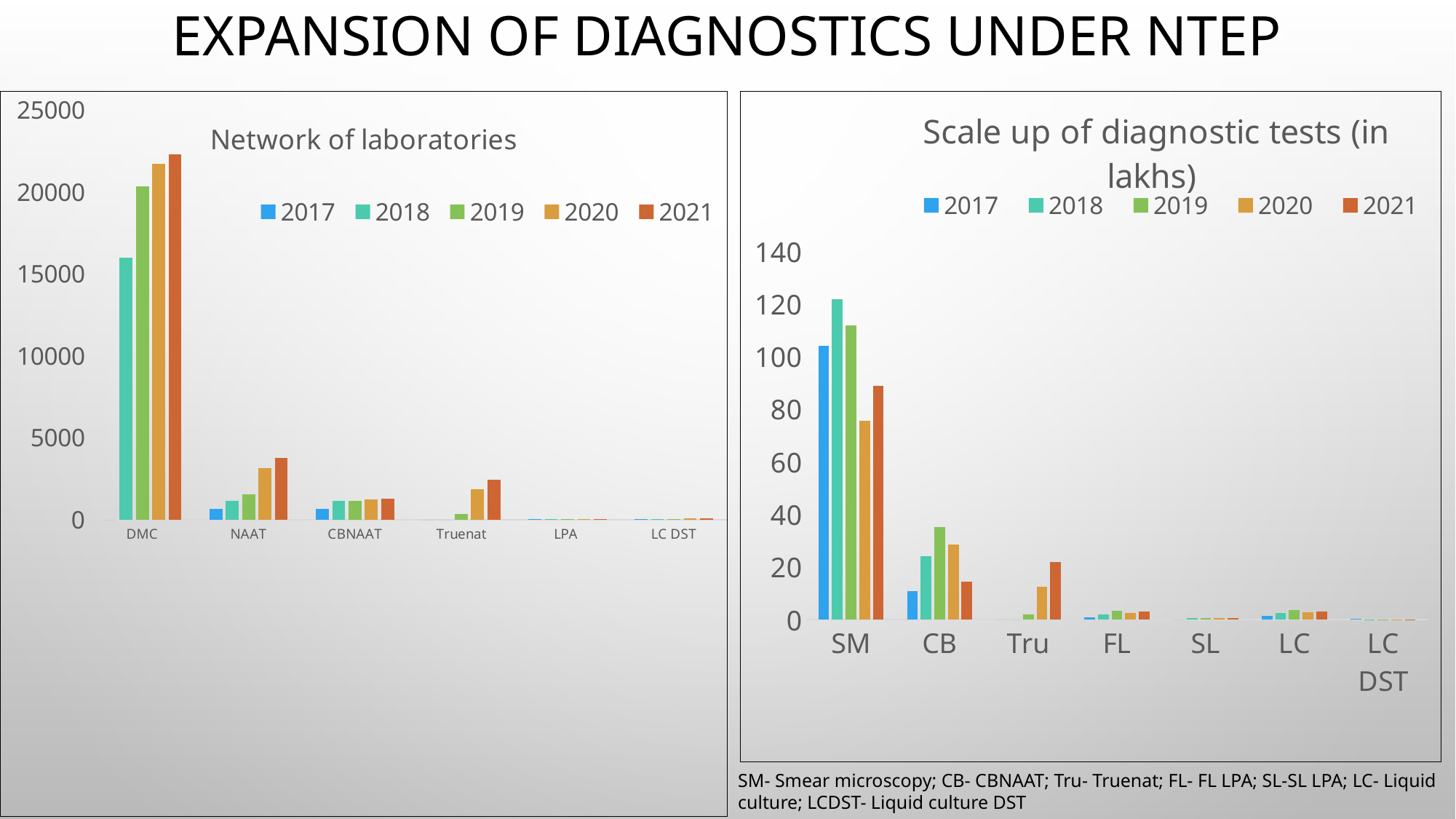
In the 'Network of laboratories' chart, which category has the highest bars? DMC In the 'Scale up of diagnostic tests (in lakhs)' chart, is the 2017 value for SM greater or less than 100? greater How many categories are shown on the x axis of the 'Scale up of diagnostic tests (in lakhs)' chart? 7 In the 'Network of laboratories' chart, do the DMC values rise or fall from 2018 to 2021? rise What is the title of the chart on the right side of the slide? Scale up of diagnostic tests (in lakhs) What type of chart is the 'Network of laboratories' chart? bar chart How many categories are shown on the x axis of the 'Network of laboratories' chart? 6 How many series does the legend of the 'Network of laboratories' chart list? 5 In the 'Network of laboratories' chart, is the 2021 value for DMC greater or less than 20000? greater In the 'Scale up of diagnostic tests (in lakhs)' chart, which is larger for CB: the 2019 value or the 2021 value? 2019 In the 'Scale up of diagnostic tests (in lakhs)' chart, which category has the highest bars? SM In the 'Network of laboratories' chart, is the 2021 value for NAAT greater or less than 5000? less